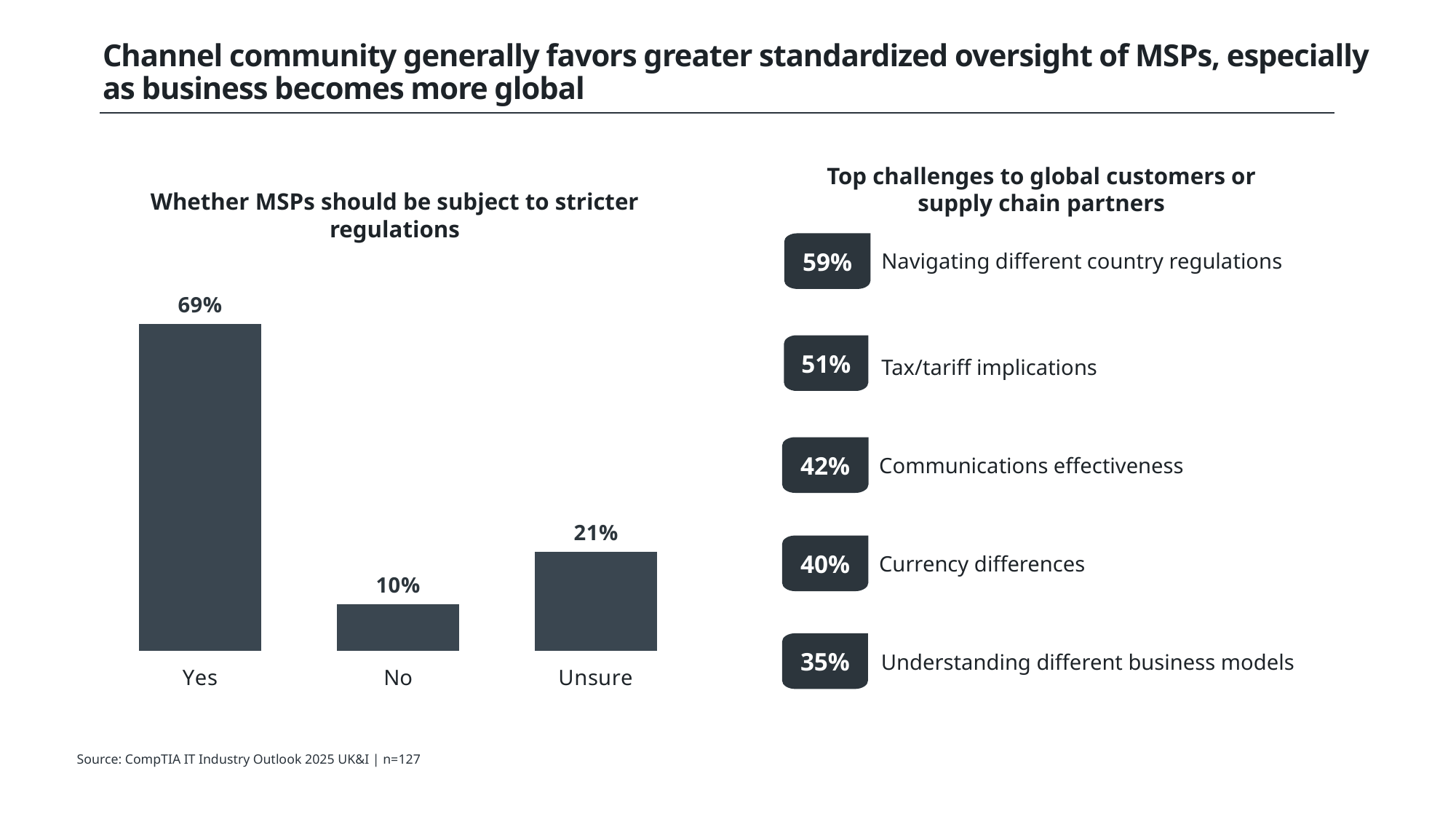
In the chart 'Whether MSPs should be subject to stricter regulations', which category has the lowest value? No In the 'Top challenges to global customers or supply chain partners' list, what is the value for Tax/tariff implications? 51% In the chart 'Whether MSPs should be subject to stricter regulations', what is the value for Unsure? 21% In the chart 'Whether MSPs should be subject to stricter regulations', what is the value for No? 10% In the 'Top challenges to global customers or supply chain partners' list, which challenge has the highest value? Navigating different country regulations In the 'Top challenges to global customers or supply chain partners' list, what is the difference between Communications effectiveness and Currency differences? 2% In the chart 'Whether MSPs should be subject to stricter regulations', which category has the highest value? Yes In the chart 'Whether MSPs should be subject to stricter regulations', what is the difference between the values for Yes and Unsure? 48% In the chart 'Whether MSPs should be subject to stricter regulations', which is larger, the value for No or the value for Unsure? Unsure In the chart 'Whether MSPs should be subject to stricter regulations', how many categories are shown? 3 In the chart 'Whether MSPs should be subject to stricter regulations', what is the value for Yes? 69% What kind of chart is 'Whether MSPs should be subject to stricter regulations'? Bar chart